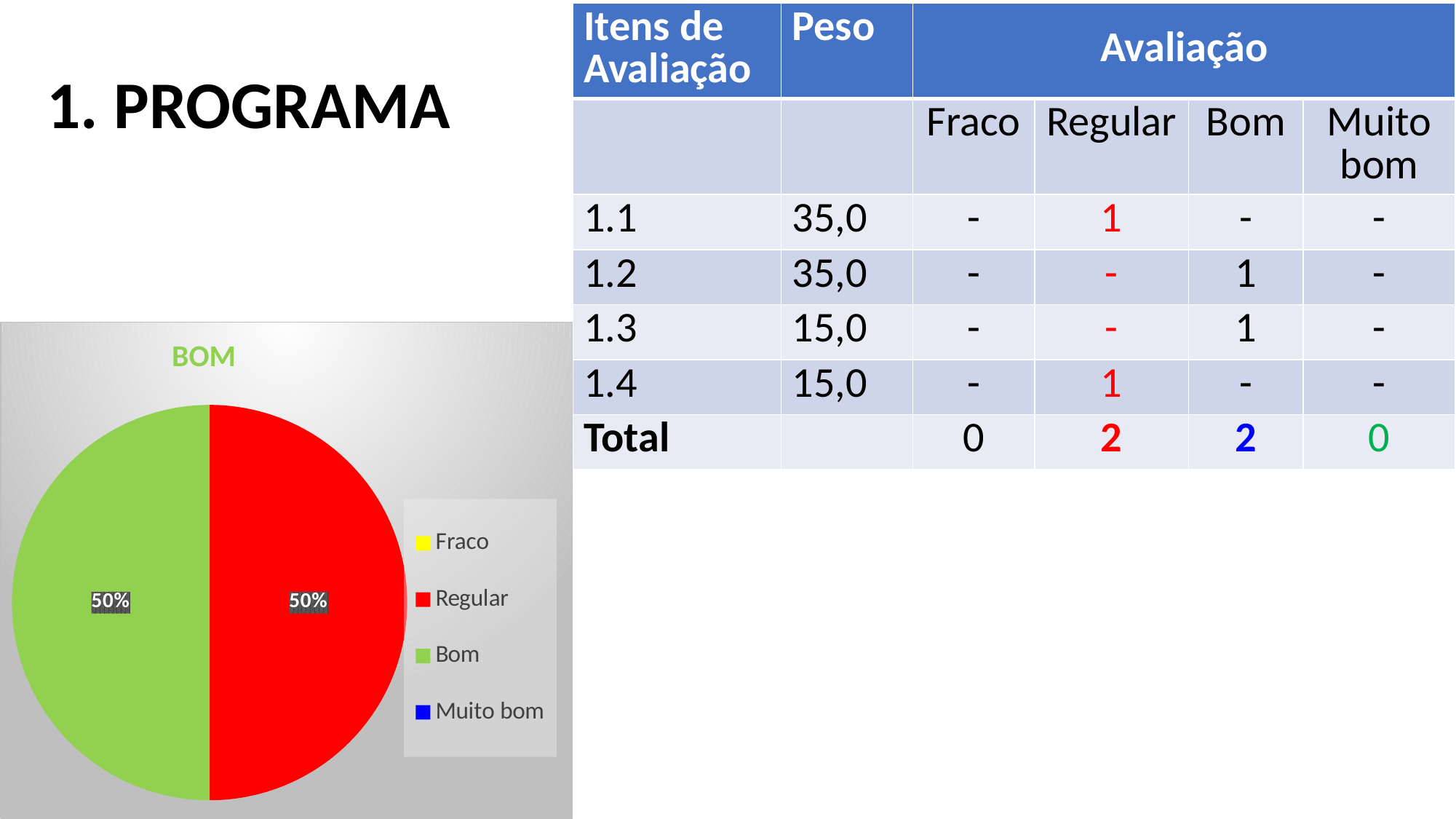
What is the combined share of the Bom and Regular slices in the pie chart? 100% What share of the pie chart does the Bom slice represent? 50% How many slices are visible in the pie chart? 2 What is the title of the pie chart? BOM What colour is the Regular slice in the pie chart? red What share of the pie chart does the Regular slice represent? 50% What kind of chart is shown on the slide? pie chart How many entries does the legend of the pie chart list? 4 Which legend entries of the pie chart have no visible slice? Fraco and Muito bom